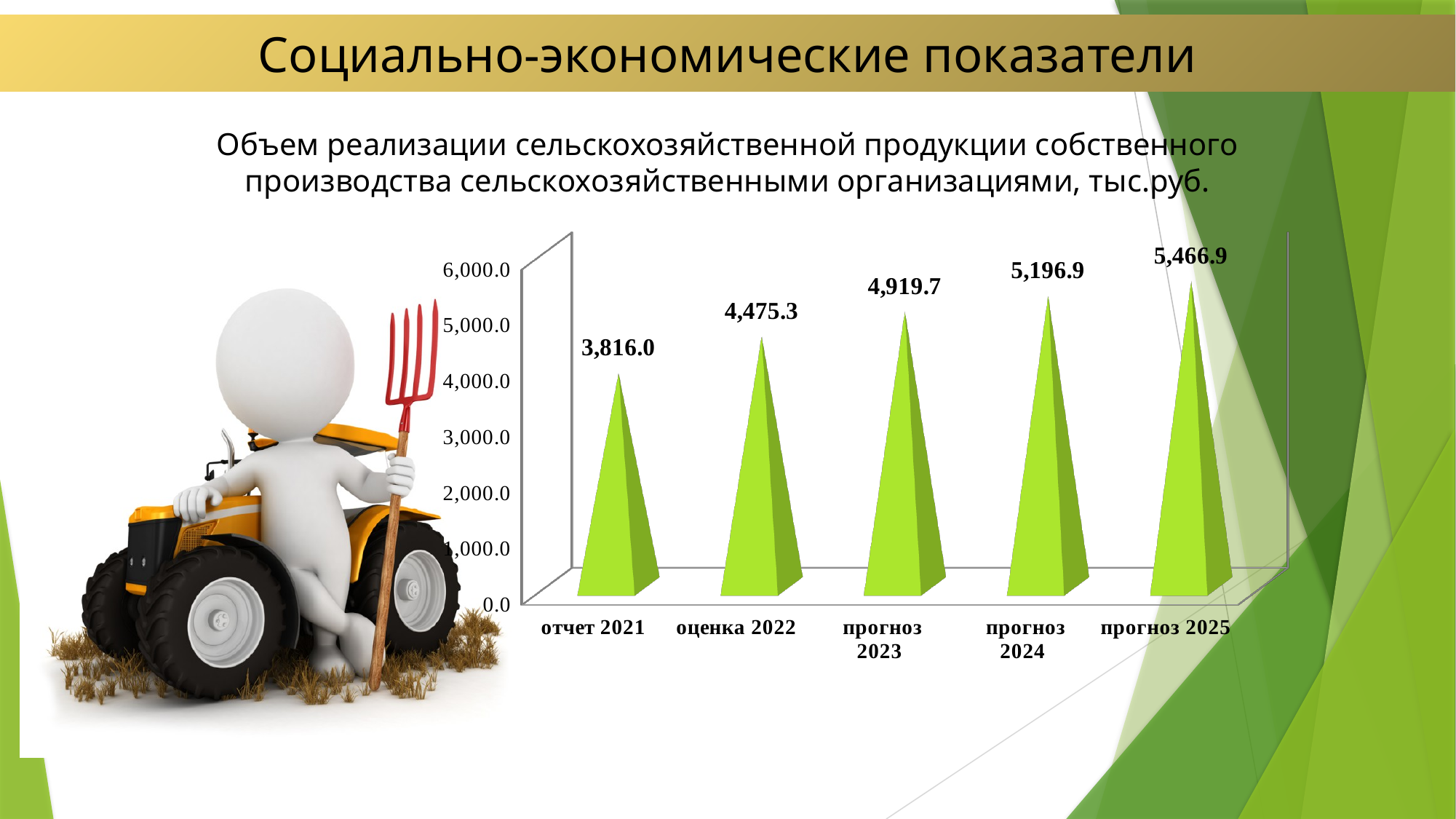
What is the value for прогноз 2024? 5,196.9 Which category has the highest value? прогноз 2025 What is the difference between the values for оценка 2022 and отчет 2021? 659.3 Which category has the lowest value? отчет 2021 What is the difference between the values for прогноз 2025 and отчет 2021? 1,650.9 Do the values rise or fall from отчет 2021 to прогноз 2025? rise Which is larger, the value for прогноз 2023 or the value for оценка 2022? прогноз 2023 What unit of measurement is stated in the chart title? тыс.руб. What is the value for оценка 2022? 4,475.3 How many categories are shown on the x axis? 5 What is the value for отчет 2021? 3,816.0 Is the value for прогноз 2023 greater or less than 4,000.0? greater